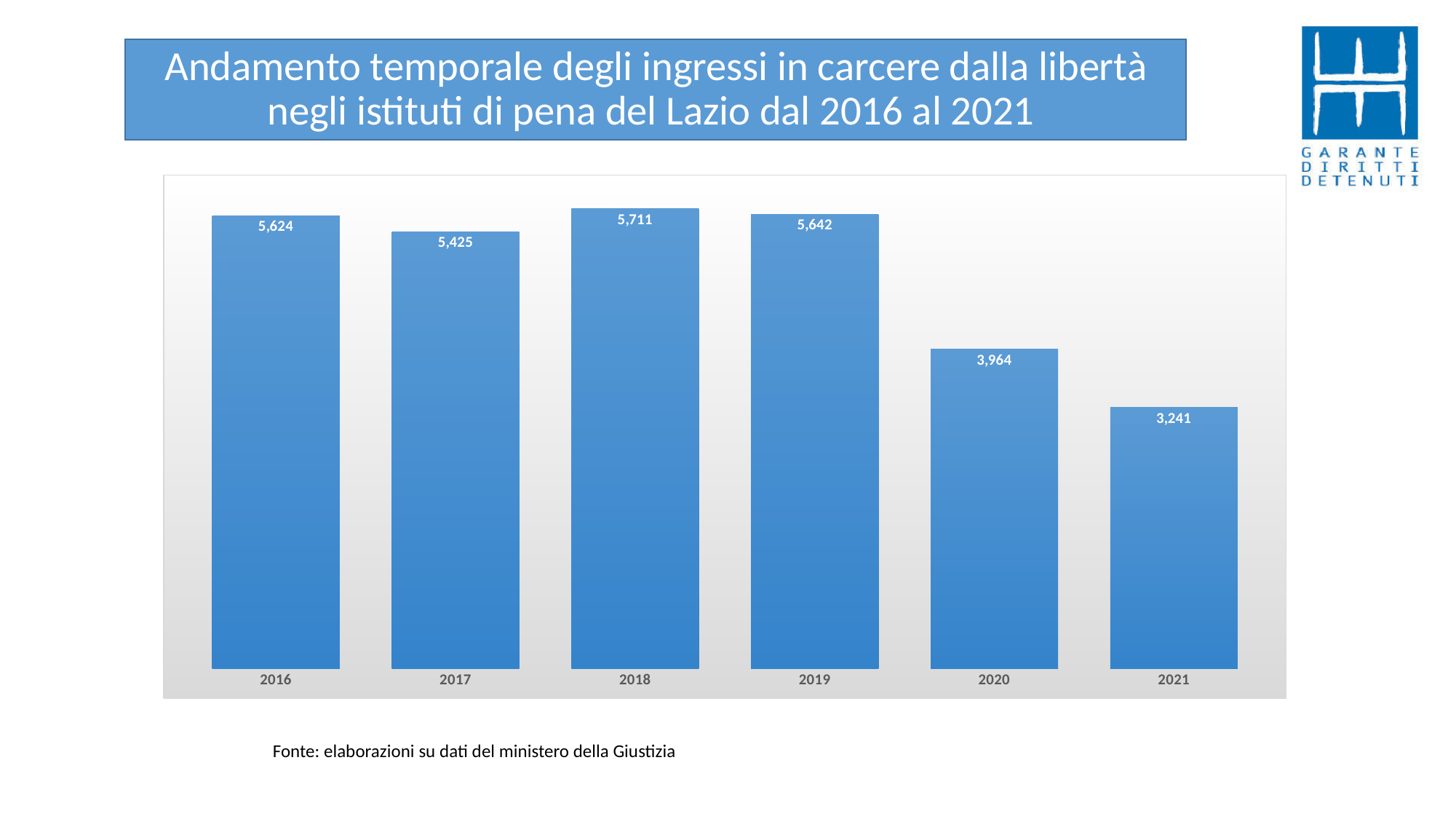
Which year has the lowest value? 2021 What kind of chart is shown on the slide? bar chart How many years are shown on the chart? 6 What is the value for 2020? 3,964 What is the difference between the values for 2020 and 2021? 723 What is the value for 2021? 3,241 What is the value for 2016? 5,624 What is the source cited below the chart? Fonte: elaborazioni su dati del ministero della Giustizia Do the values rise or fall from 2019 to 2021? fall Which year has the highest value? 2018 What is the difference between the values for 2018 and 2017? 286 Which is larger, the value for 2016 or the value for 2017? 2016